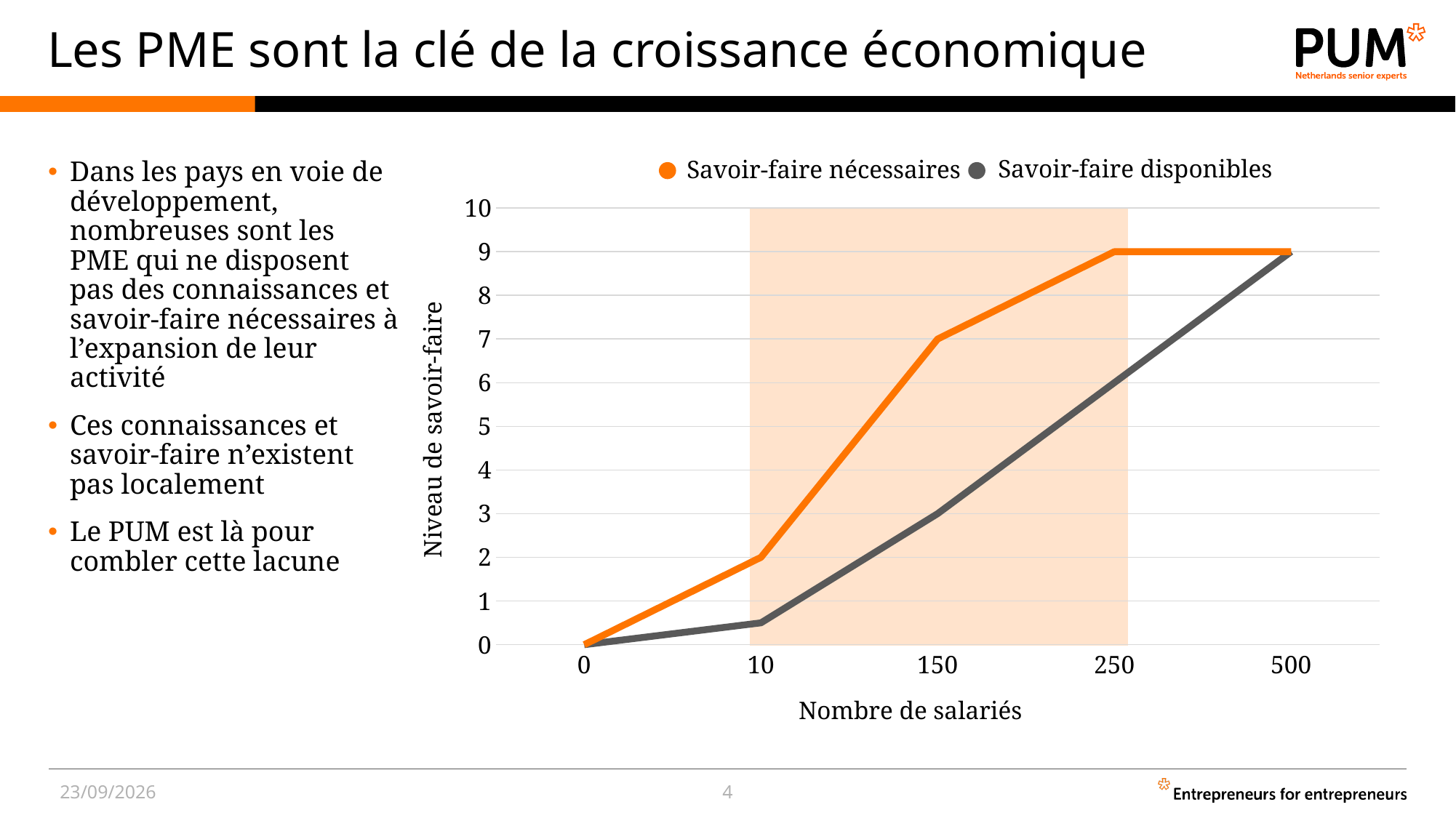
What is the difference between Savoir-faire nécessaires and Savoir-faire disponibles at 150 salariés? 4 What is the value of Savoir-faire disponibles at 150 salariés? 3 What is the value of Savoir-faire nécessaires at 150 salariés? 7 Is the value for Savoir-faire disponibles at 250 salariés greater or less than 4? greater At 150 salariés, which series has the higher value, Savoir-faire nécessaires or Savoir-faire disponibles? Savoir-faire nécessaires What is the title of the y axis? Niveau de savoir-faire What kind of chart is shown on the slide? line chart Does the Savoir-faire disponibles line rise or fall as the number of salariés increases? rise How many points are labelled on the x axis (Nombre de salariés)? 5 What is the value of Savoir-faire nécessaires at 250 salariés? 9 How many series does the legend list? 2 What is the value of Savoir-faire nécessaires at 10 salariés? 2